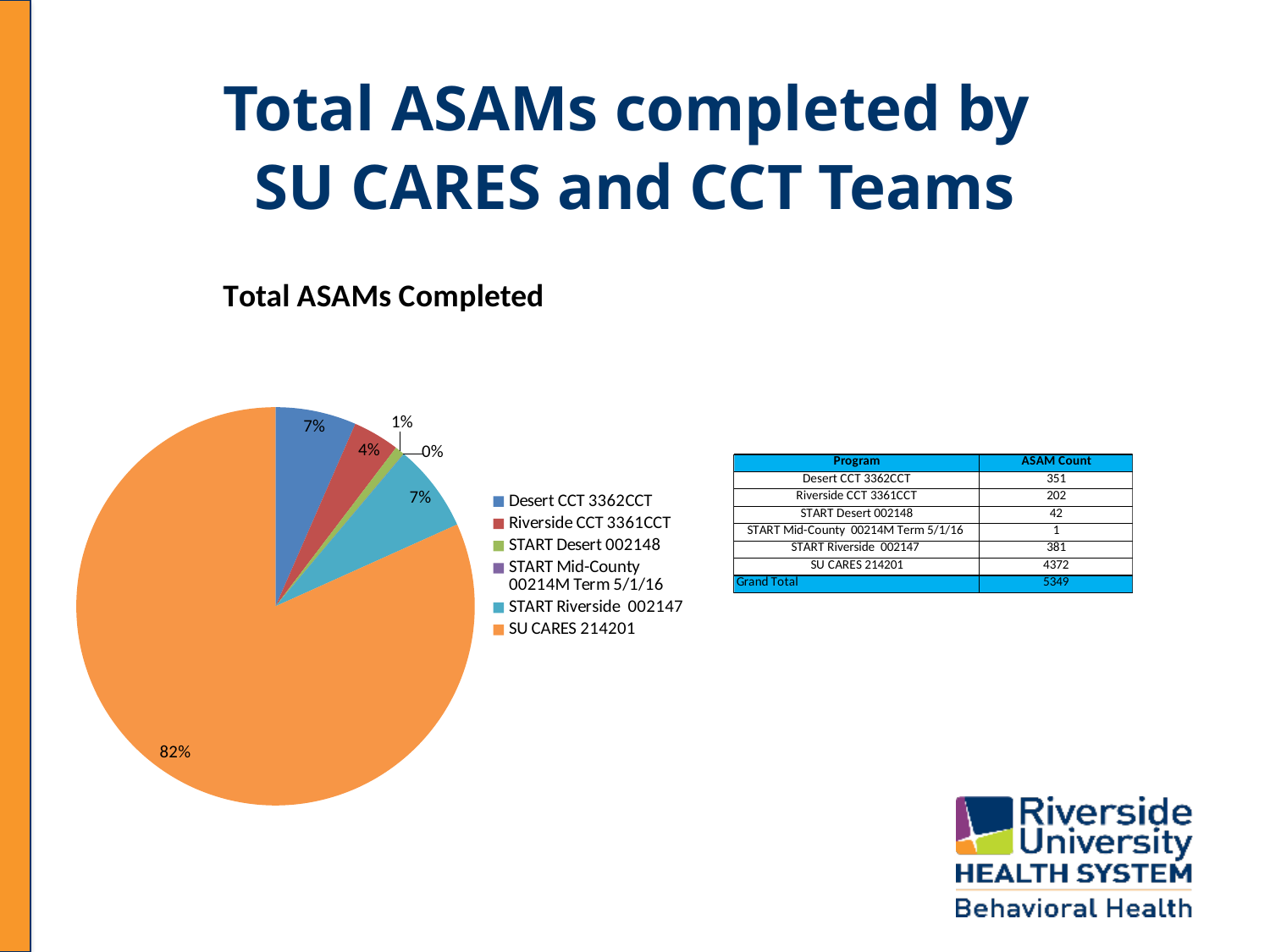
What is the title of the chart? Total ASAMs Completed Which program has the largest slice of the pie? SU CARES 214201 How many entries does the legend list? 6 What share of the pie does Riverside CCT 3361CCT represent? 4% Which is larger: the slice for Riverside CCT 3361CCT or the slice for START Desert 002148? Riverside CCT 3361CCT How many programs (slices) does the pie chart show? 6 What share of the pie does SU CARES 214201 represent? 82% What kind of chart is shown on the slide? pie chart What is the difference in percentage points between the SU CARES 214201 slice and the Riverside CCT 3361CCT slice? 78% What share of the pie does START Desert 002148 represent? 1% Which program has the smallest slice of the pie? START Mid-County 00214M Term 5/1/16